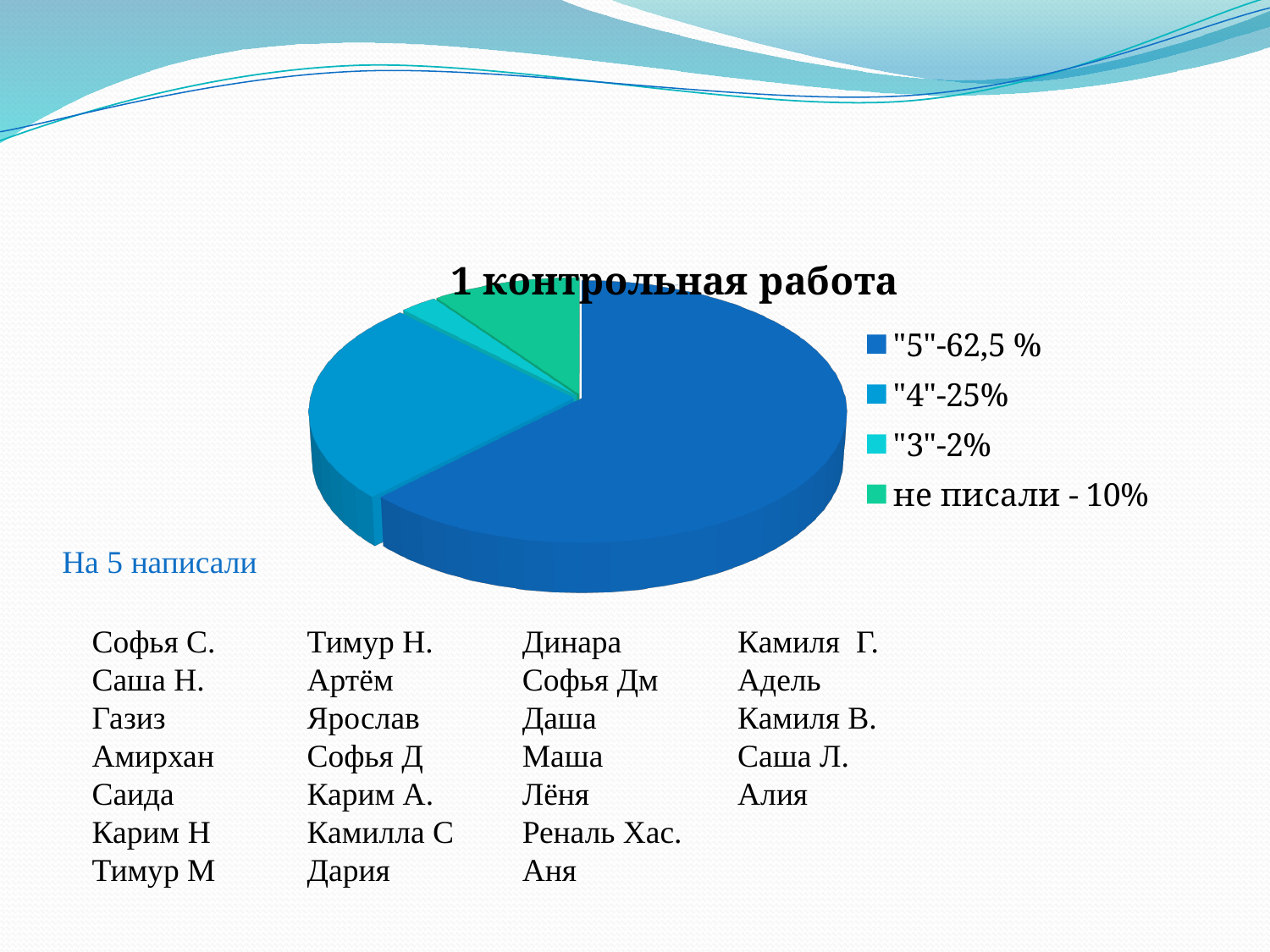
What kind of chart is shown on the slide? pie chart Which category has the largest slice of the pie? "5" What colour is the slice for the "5" category? blue What is the difference between the share for "5" and the share for "4"? 37,5 % How many slices does the pie chart have? 4 What share of the pie does the "4" category have? 25% What share of the pie does the "3" category have? 2% What is the title of the chart? 1 контрольная работа What share of the pie does the "не писали" category have? 10% Which is larger: the share for "4" or the share for "не писали"? "4" Which category has the smallest slice of the pie? "3"